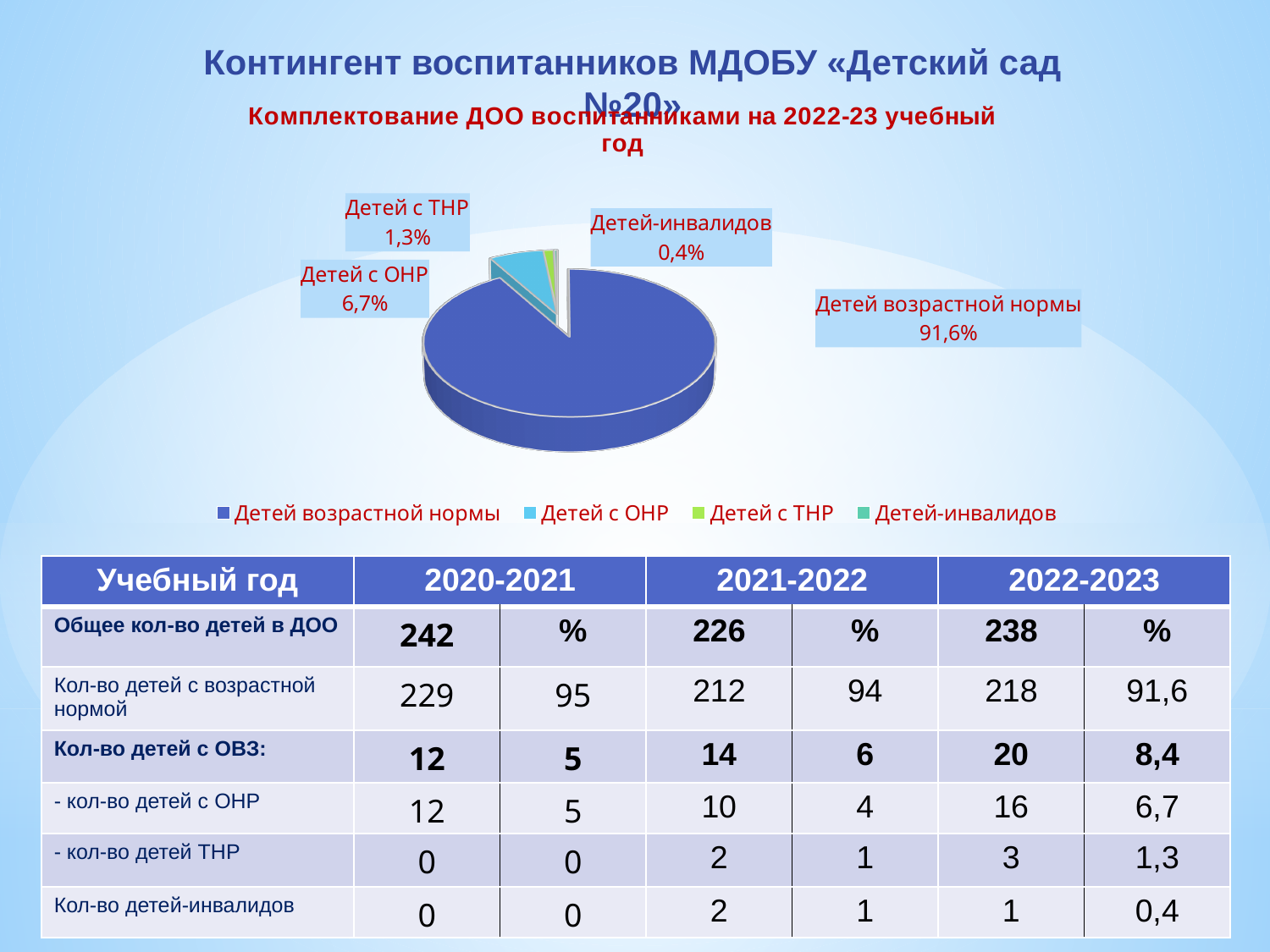
Which category has the largest slice of the pie? Детей возрастной нормы How many entries does the chart legend list? 4 How many slices does the pie chart have? 4 What is the title of the chart? Комплектование ДОО воспитанниками на 2022-23 учебный год What is the difference in percentage points between the "Детей с ОНР" slice and the "Детей с ТНР" slice? 5,4 Which category has the smallest slice of the pie? Детей-инвалидов What share of the pie is labelled "Детей с ТНР"? 1,3% What share of the pie is labelled "Детей-инвалидов"? 0,4% What share of the pie is labelled "Детей возрастной нормы"? 91,6% Which slice is larger: "Детей с ОНР" or "Детей с ТНР"? Детей с ОНР What share of the pie is labelled "Детей с ОНР"? 6,7% What kind of chart is shown on the slide? pie chart